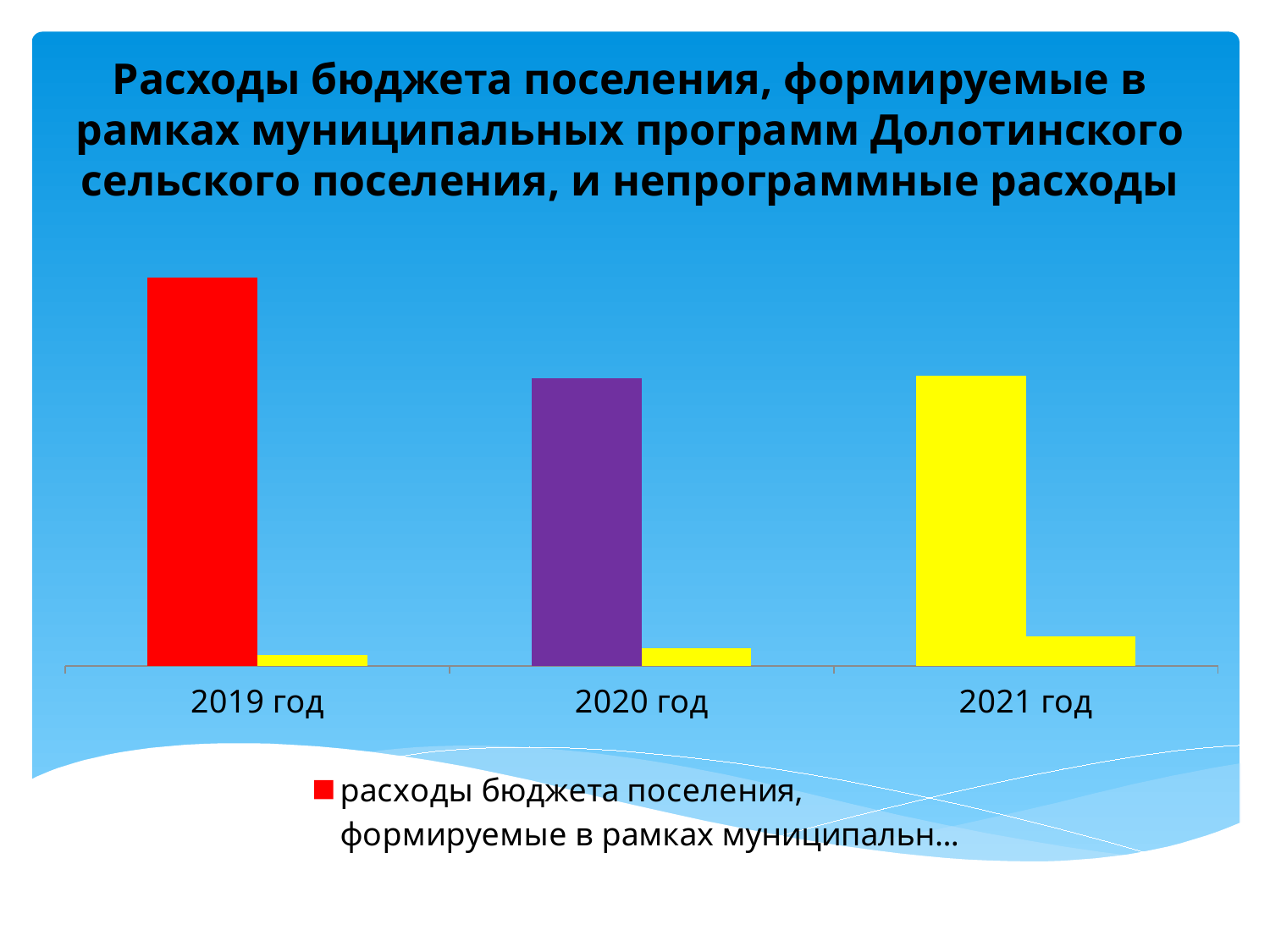
Is the small second bar for 2021 год taller or shorter than the small second bar for 2019 год? taller How many year categories are shown on the x axis of the chart? 3 What colour is the large bar for 2019 год? red Is the large bar for 2019 год taller or shorter than the large bar for 2020 год? taller Which year has the tallest first (large) bar in the chart? 2019 год Which year has the tallest second (small yellow) bar in the chart? 2021 год What kind of chart is shown on the slide? bar chart What colour is the large bar for 2020 год? purple Does the height of the first (large) bar rise or fall from 2019 год to 2020 год? fall Does the height of the second (small) bar rise or fall from 2019 год to 2021 год? rise